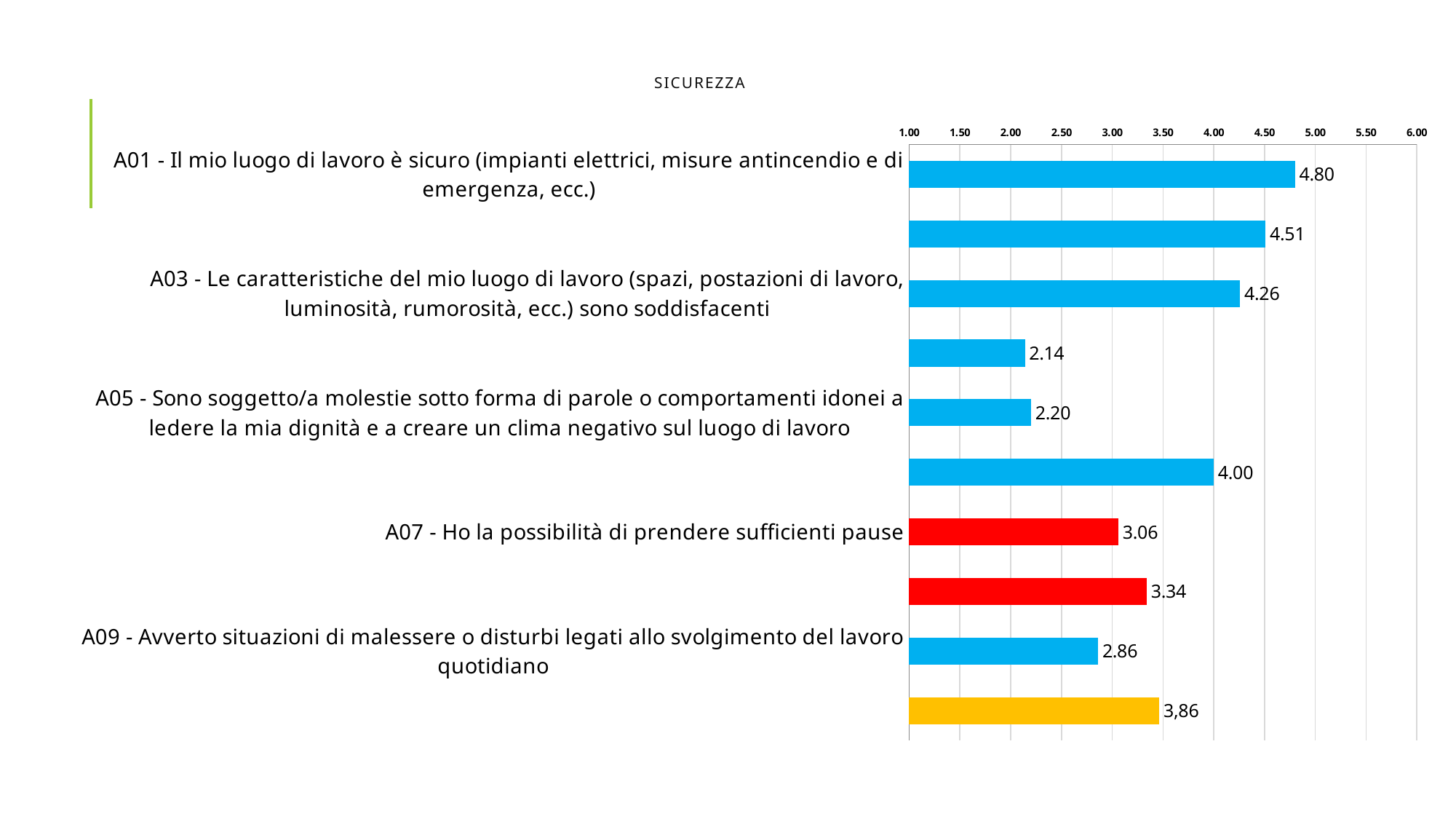
Which labelled category has the highest value? A01 What kind of chart is shown on the slide? bar chart What is the value for A01 - Il mio luogo di lavoro è sicuro? 4.80 What is the value for A07 - Ho la possibilità di prendere sufficienti pause? 3.06 What is the value for A03 - Le caratteristiche del mio luogo di lavoro sono soddisfacenti? 4.26 What is the difference between the values for A01 and A03? 0.54 Which has a larger value, A05 or A07? A07 What is the lowest value shown on the chart? 2.14 How many bars are plotted on the chart? 10 What is the value for A05 - Sono soggetto/a molestie? 2.20 What is the title of the chart? SICUREZZA What is the value for A09 - Avverto situazioni di malessere o disturbi? 2.86